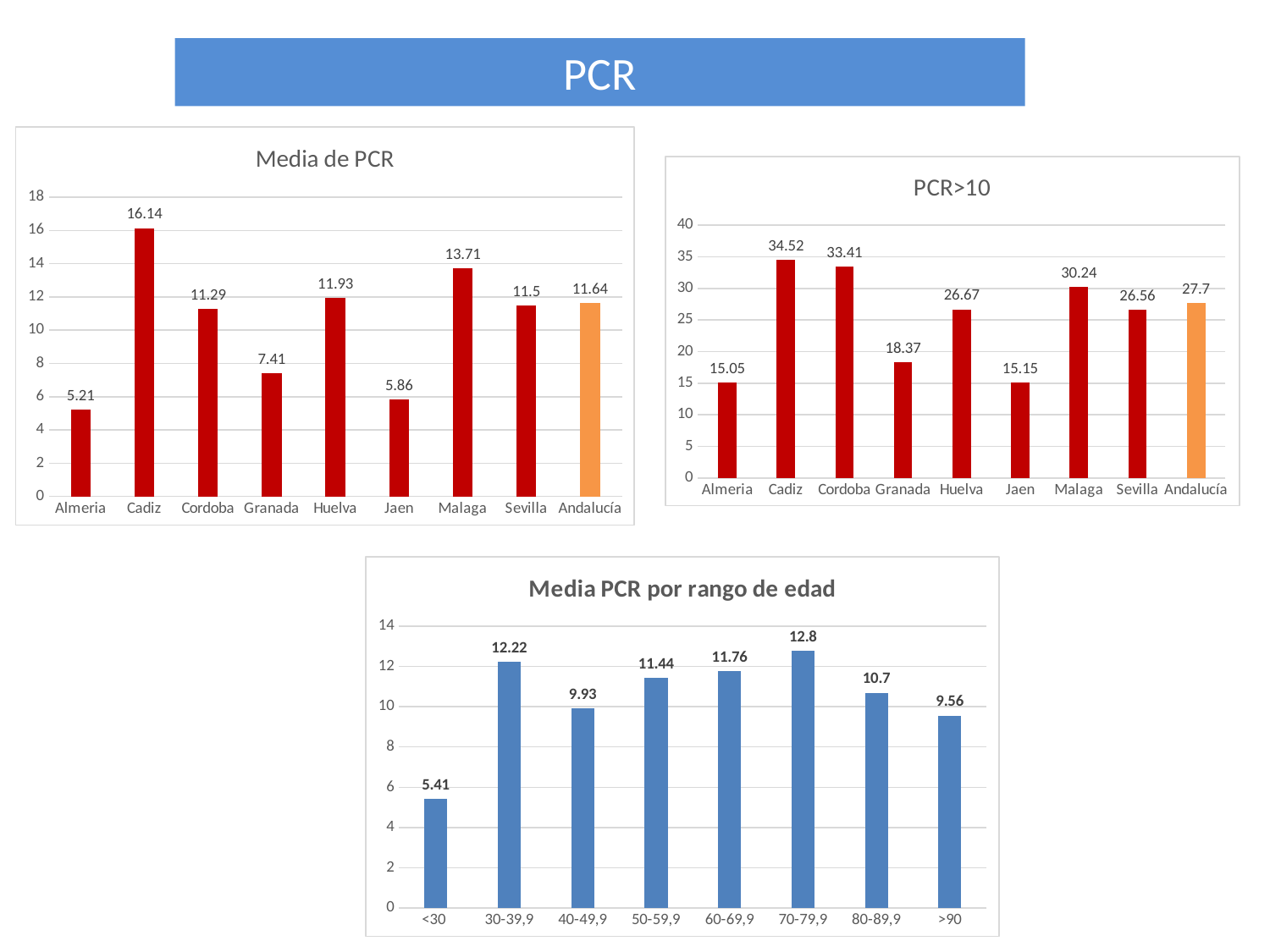
In the 'PCR>10' chart, what is the value for Andalucía? 27.7 In the 'Media PCR por rango de edad' chart, what is the value for the 40-49,9 age range? 9.93 In the 'Media PCR por rango de edad' chart, what is the difference between the values for 30-39,9 and <30? 6.81 In the 'Media de PCR' chart, what is the difference between the values for Malaga and Granada? 6.3 In the 'PCR>10' chart, how many categories are shown? 9 In the 'PCR>10' chart, which is larger, the value for Huelva or the value for Granada? Huelva In the 'Media de PCR' chart, which category has the lowest value? Almeria What kind of chart is 'Media PCR por rango de edad'? Bar chart In the 'PCR>10' chart, which category has the highest value? Cadiz In the 'Media de PCR' chart, which bar is shown in a different colour (orange) from the others? Andalucía In the 'Media PCR por rango de edad' chart, which age range has the highest value? 70-79,9 In the 'Media de PCR' chart, what is the value for Cadiz? 16.14